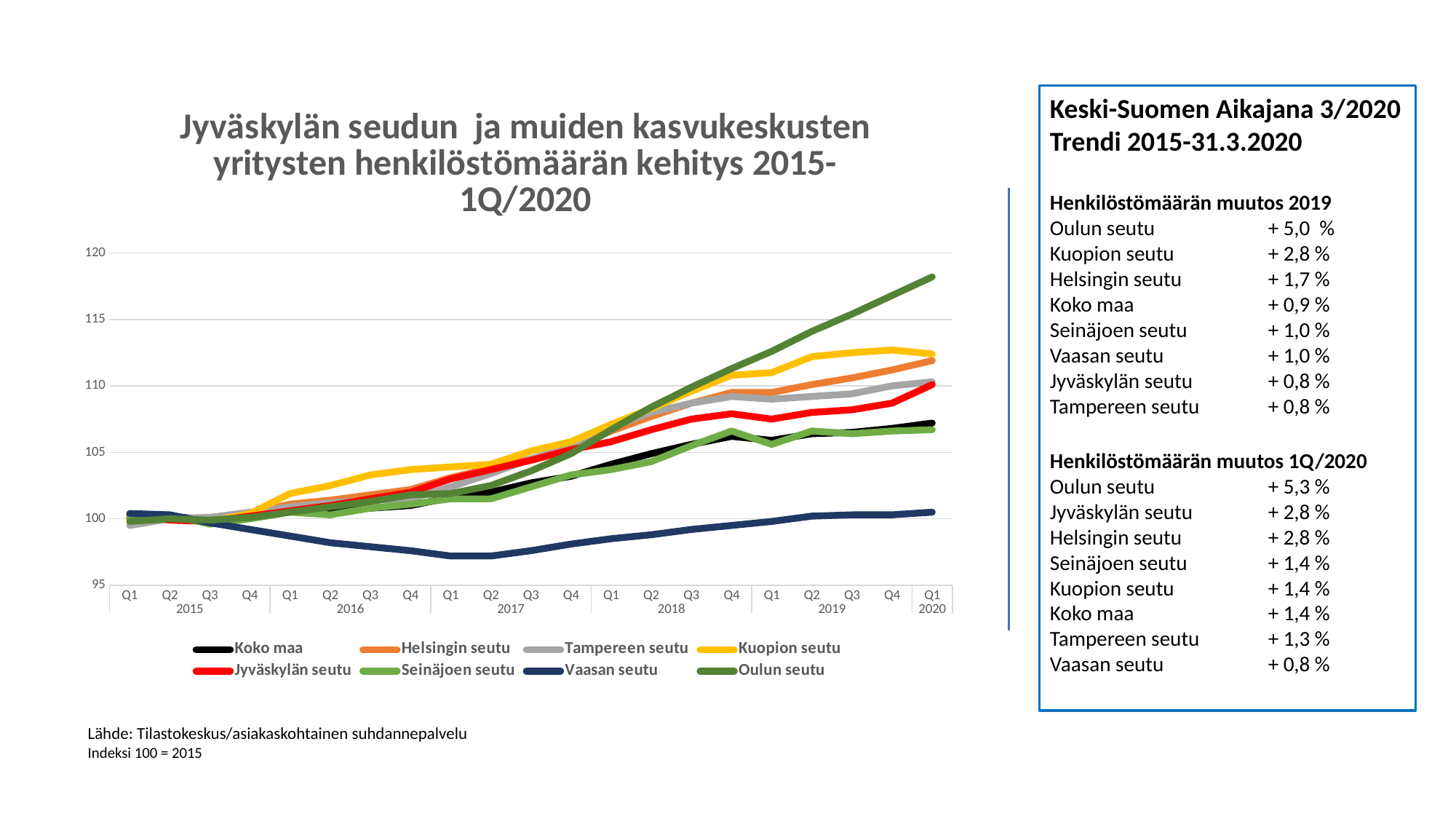
Does the Oulun seutu line rise or fall from Q1 2018 to Q1 2020? rise Which series has the lowest value at Q1 2020? Vaasan seutu Which is larger at Q1 2020, the value for Kuopion seutu or the value for Koko maa? Kuopion seutu Is the value for Vaasan seutu at Q1 2017 greater or less than 100? less Is the value for Oulun seutu at Q1 2020 greater or less than 115? greater Which series has the highest value at Q1 2020? Oulun seutu How many series does the chart legend list? 8 Is the value for Kuopion seutu at Q4 2019 greater or less than 110? greater What kind of chart is shown on the slide? line chart Which series is drawn in dark blue in the chart? Vaasan seutu How many quarterly points are plotted along the x axis of the chart? 21